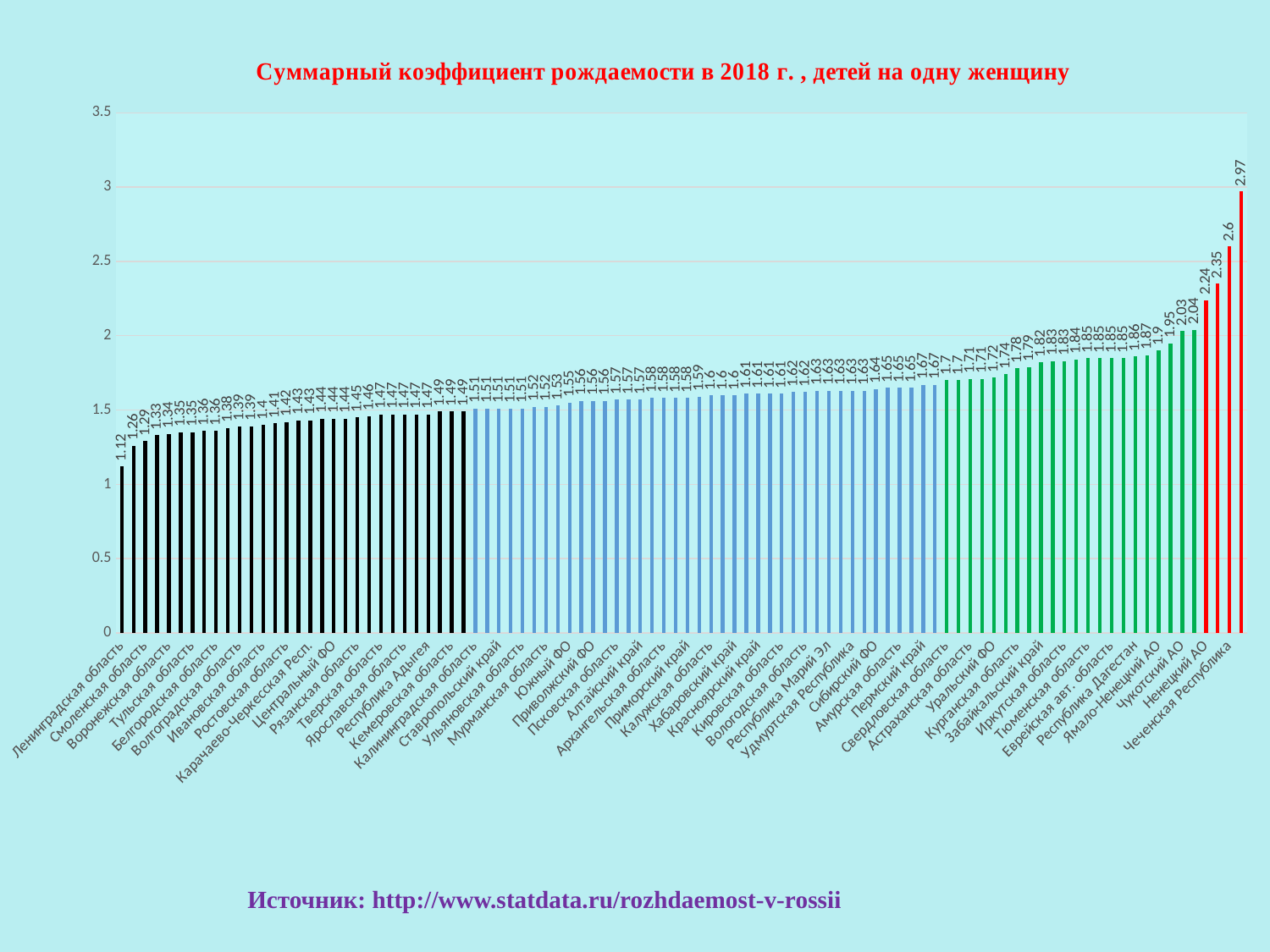
Is the value for Ленинградская область greater or less than 1.5? less What is the value for Ленинградская область? 1.12 What is the second highest value shown in the chart? 2.6 What is the highest value shown in the chart? 2.97 What is the title of the chart? Суммарный коэффициент рождаемости в 2018 г. , детей на одну женщину Do the values rise or fall from left to right along the x axis? rise Is the value of the rightmost bar greater or less than 2.5? greater What kind of chart is shown on the slide? bar chart What is the lowest value shown in the chart? 1.12 What is the difference between the highest value (2.97) and the lowest value (1.12) in the chart? 1.85 Which is larger, the value of the leftmost bar or the value of the rightmost bar? the rightmost bar How many bars are coloured red in the chart? 4